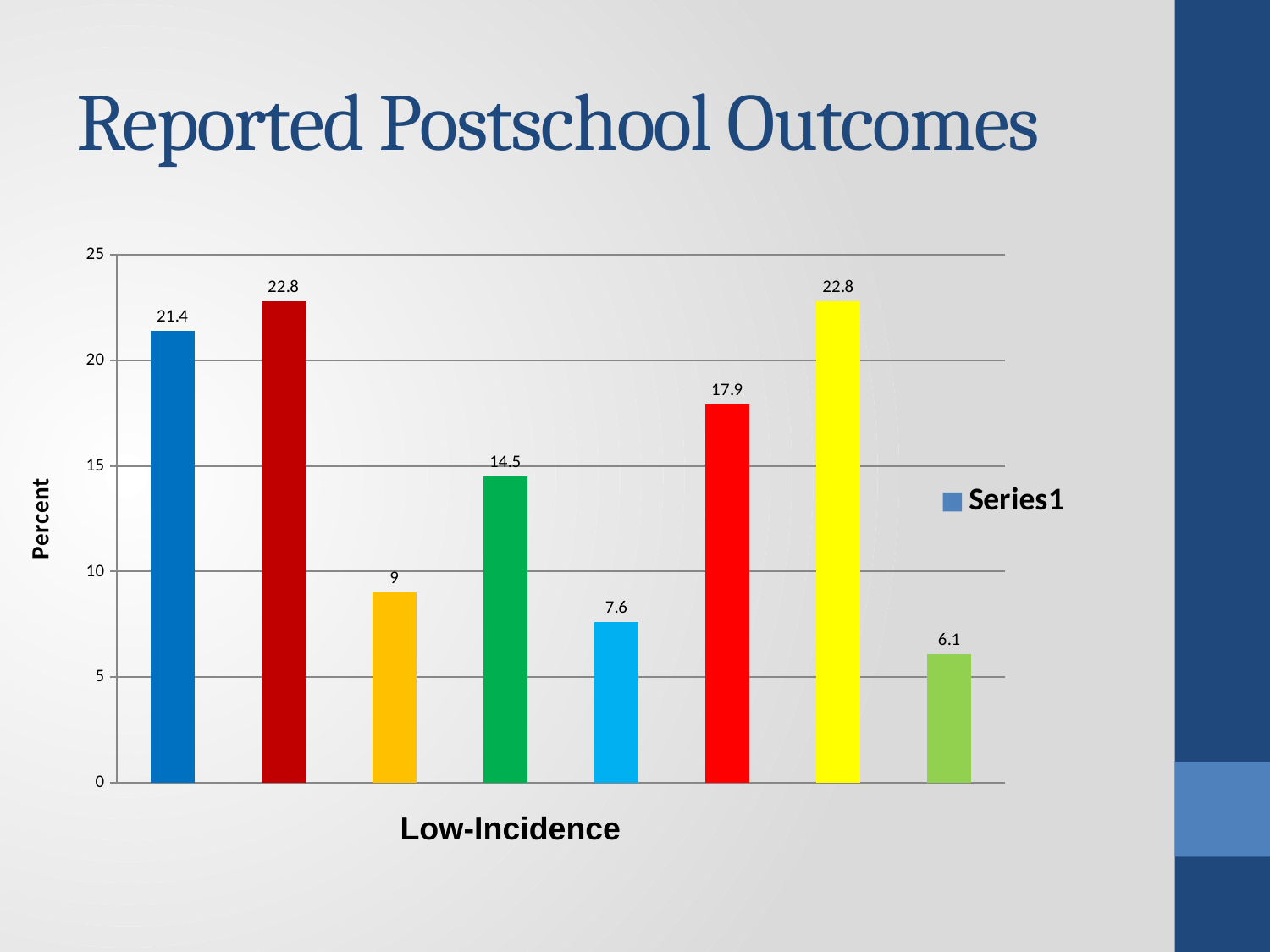
What is the highest value shown in the chart? 22.8 What is the value of the green bar, the fourth from the left? 14.5 What is the value of the orange bar, the third from the left? 9 What is the lowest value shown in the chart, and which bar has it? 6.1, the last (light green) bar What is the value of the first (dark blue) bar in the chart? 21.4 Which is larger: the value of the sixth bar (red) or the fourth bar (green)? The sixth bar (red), 17.9 What is the label on the vertical axis of the chart? Percent What is the difference between the value of the yellow bar (22.8) and the light green bar (6.1)? 16.7 What type of chart is shown on the slide? Bar chart What is the value of the light blue bar, the fifth from the left? 7.6 How many bars are plotted in the chart? 8 Is the value of the first (dark blue) bar greater or less than 20? greater